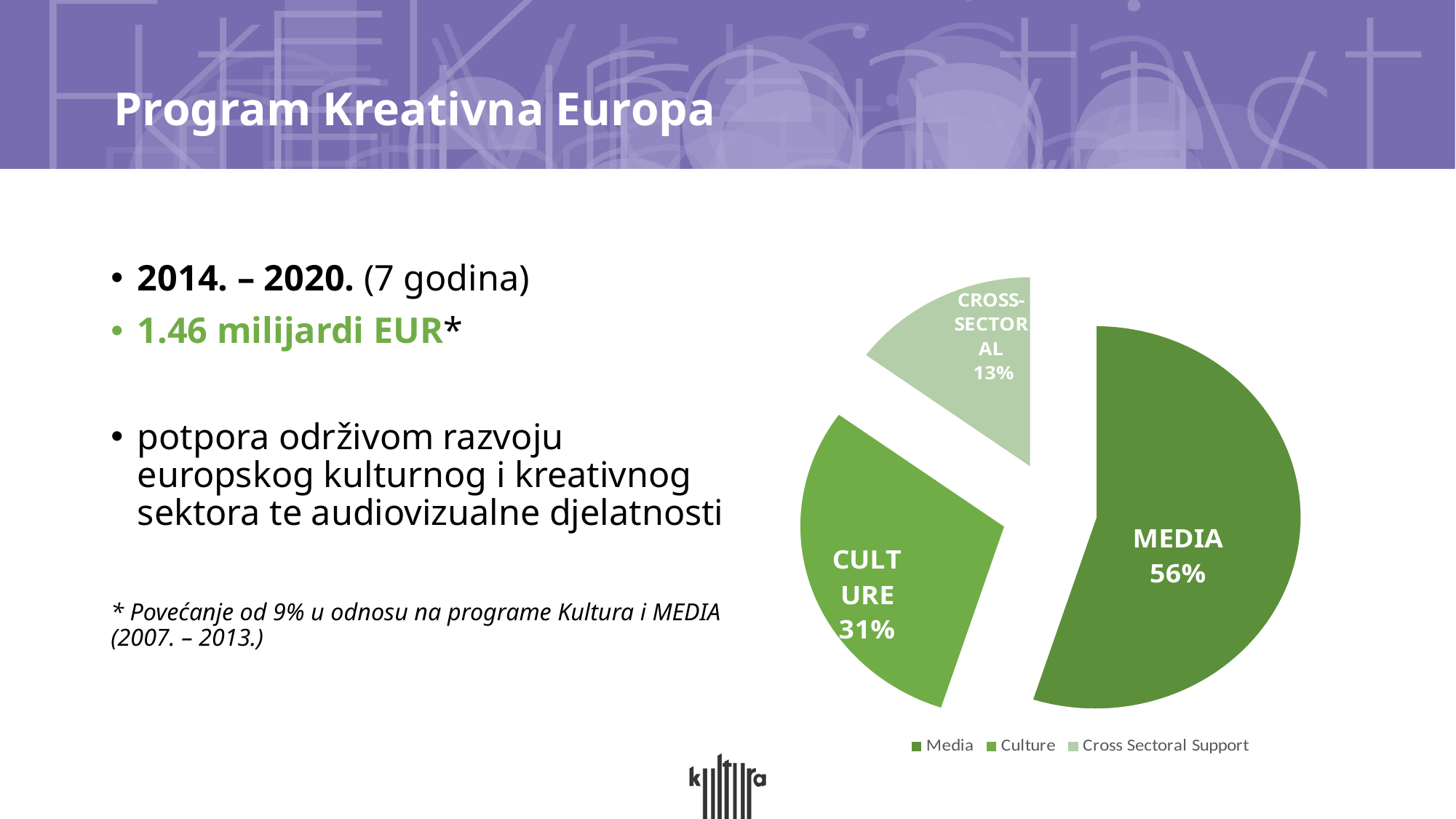
Which legend entry is shown in the lightest shade of green? Cross Sectoral Support Which is larger, the Culture slice or the Cross Sectoral Support slice? Culture What share of the pie does Culture have? 31% Which slice of the pie is the largest? Media What share of the pie does Cross Sectoral Support have? 13% What is the difference in percentage points between the Media and Culture slices? 25 What kind of chart is shown on the slide? pie chart How many entries does the chart legend list? 3 How many slices does the pie chart have? 3 Which slice of the pie is the smallest? Cross Sectoral Support What share of the pie does Media have? 56% What is the difference in percentage points between the Culture and Cross Sectoral Support slices? 18